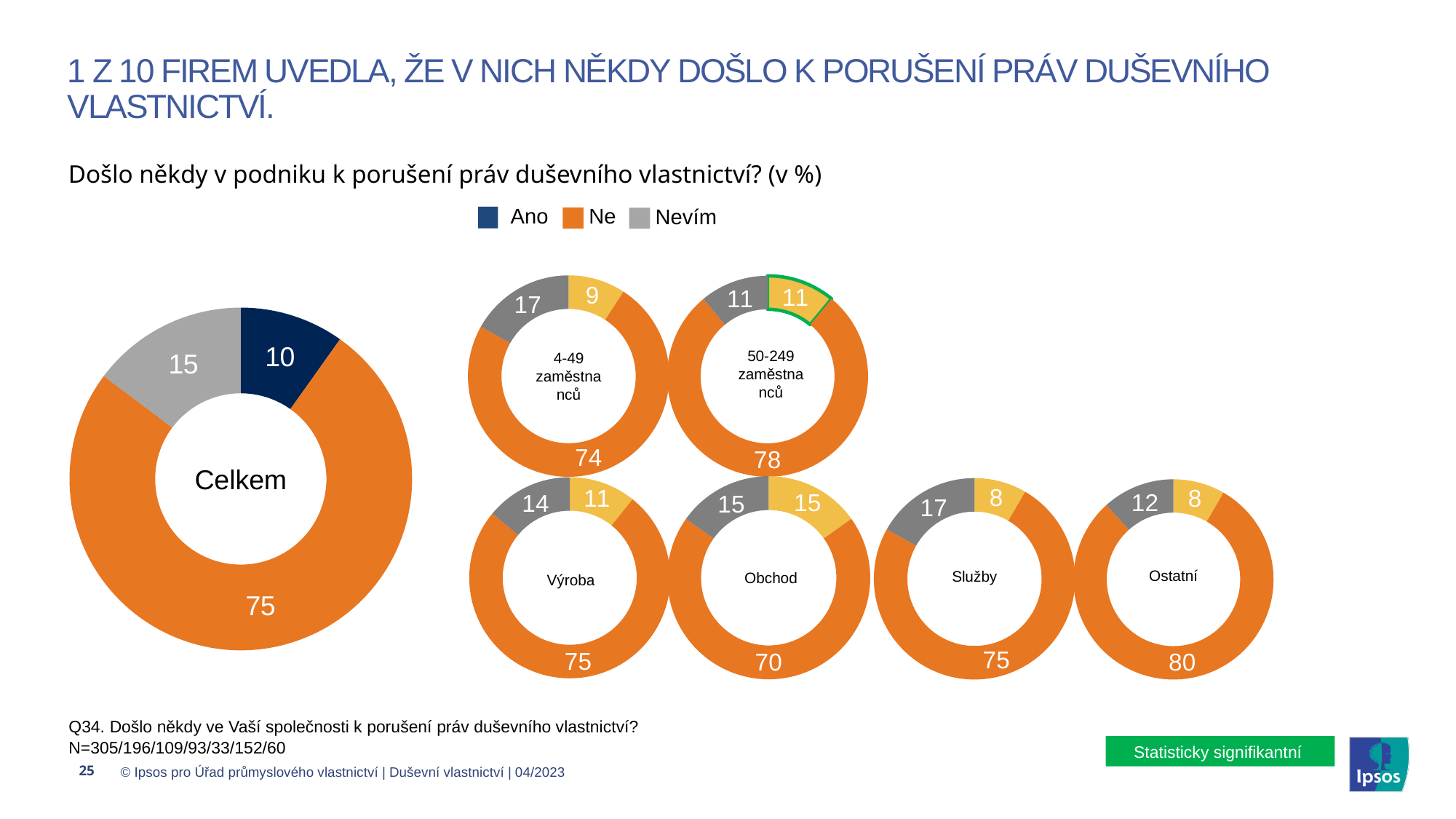
In the Celkem chart, what is the value for Ne? 75 In the 50-249 zaměstnanců chart, what is the value for Ano? 11 How many series does the legend list? 3 In the Ostatní chart, what is the value for Ne? 80 What kind of chart is the Celkem chart? Donut chart In the Celkem chart, what is the difference between the values for Ne and Nevím? 60 Is the value for Ne in the Ostatní chart larger or smaller than the value for Ne in the Obchod chart? larger In the Služby chart, which category has the highest value? Ne In the Obchod chart, what is the value for Ne? 70 In the Celkem chart, what is the value for Ano? 10 In the 4-49 zaměstnanců chart, what is the difference between the values for Nevím and Ano? 8 In the Celkem chart, which category has the lowest value? Ano